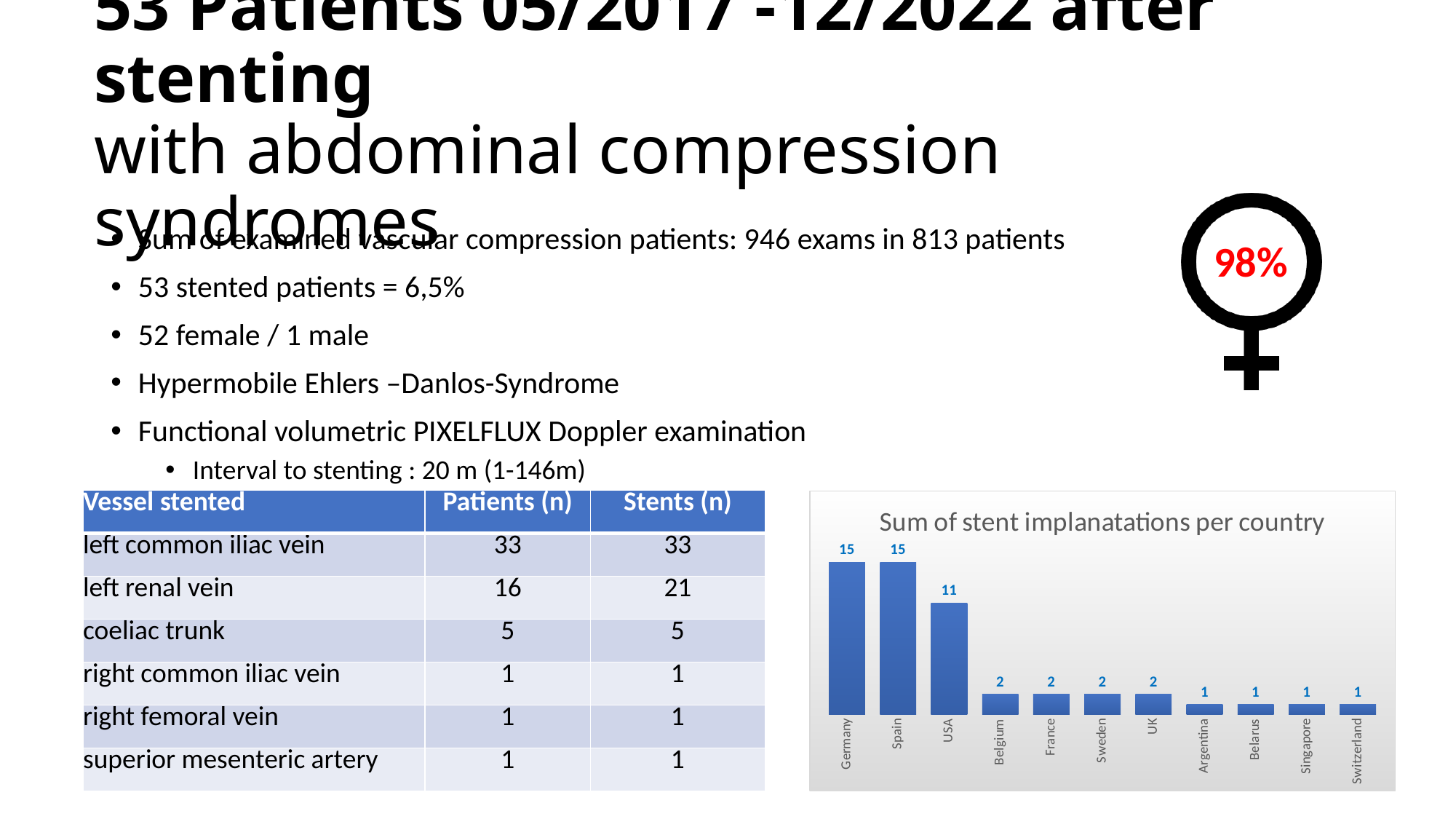
Which is larger, the value for USA or the value for France? USA Do the values rise or fall from left to right along the x axis? fall Which country has the lowest value in the chart, among Argentina, Belarus, Singapore and Switzerland, what value do they share? 1 What is the value for Germany in the chart? 15 What is the difference between the values for Germany and Belgium? 13 What is the value for Singapore in the chart? 1 What is the difference between the values for Spain and USA? 4 What is the title of the chart? Sum of stent implanatations per country What is the value for Belgium in the chart? 2 What is the value for USA in the chart? 11 How many countries are shown in the chart? 11 What kind of chart is shown on the slide? bar chart